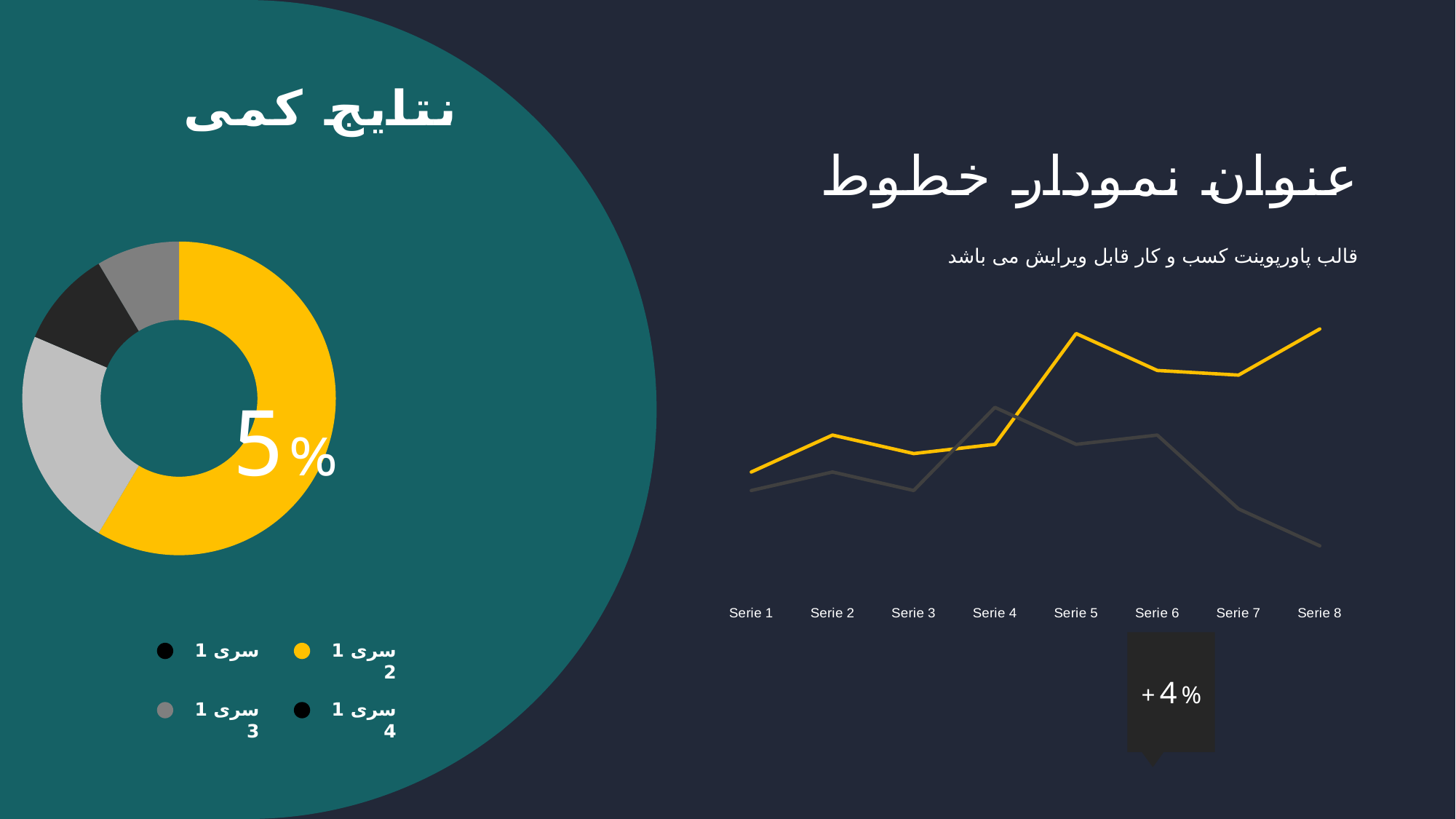
Which colour slice is the largest in the donut chart on the left? yellow In the line chart on the right, at which category does the yellow line reach its lowest point? Serie 1 In the line chart on the right, at which category does the grey line reach its highest point? Serie 4 What kind of chart is the chart on the left of the slide, titled "نتایج کمی"? donut chart In the line chart on the right, at which category does the grey line reach its lowest point? Serie 8 In the line chart on the right, which line is higher at Serie 8, the yellow line or the grey line? the yellow line What kind of chart is the chart on the right of the slide, titled "عنوان نمودار خطوط"? line chart How many categories are shown on the x axis of the line chart on the right? 8 In the line chart on the right, which line is higher at Serie 4, the yellow line or the grey line? the grey line How many entries does the legend of the donut chart on the left list? 4 In the line chart on the right, does the grey line rise or fall from Serie 4 to Serie 8? fall How many slices does the donut chart on the left have? 4